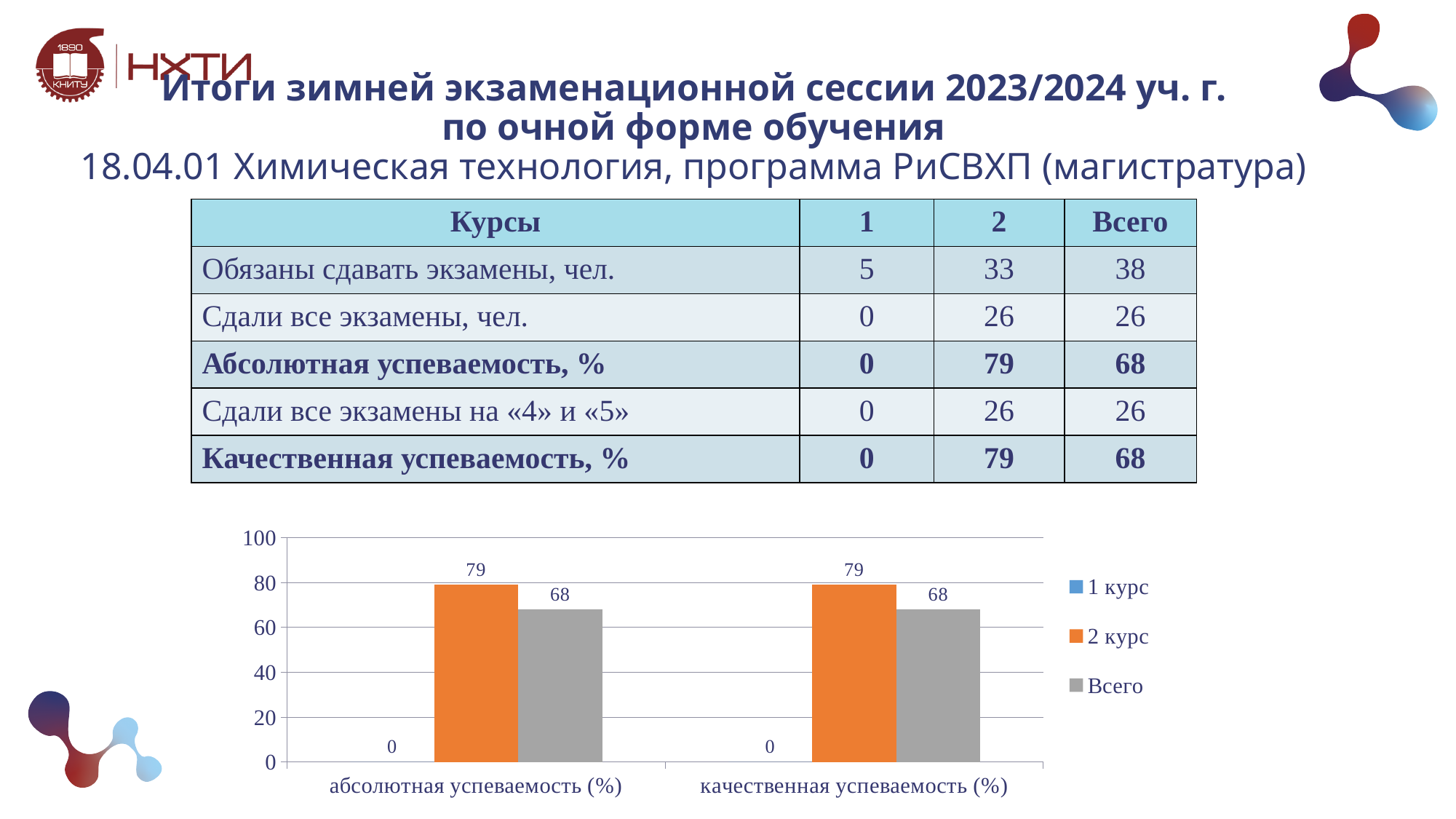
How many series does the chart legend list? 3 Which series has the lowest value in the "абсолютная успеваемость (%)" category? 1 курс Is the value for "Всего" in the "абсолютная успеваемость (%)" category greater or less than 60? greater What colour are the bars for the "2 курс" series? orange What is the value for "1 курс" in the "абсолютная успеваемость (%)" category? 0 What is the value for "2 курс" in the "абсолютная успеваемость (%)" category? 79 What is the value for "Всего" in the "качественная успеваемость (%)" category? 68 How many categories are shown on the x axis of the chart? 2 What is the difference between the "2 курс" and "Всего" values in the "абсолютная успеваемость (%)" category? 11 In the "качественная успеваемость (%)" category, which is larger: the value for "2 курс" or for "Всего"? 2 курс Which series has the highest value in the "качественная успеваемость (%)" category? 2 курс What kind of chart is shown on the slide? bar chart